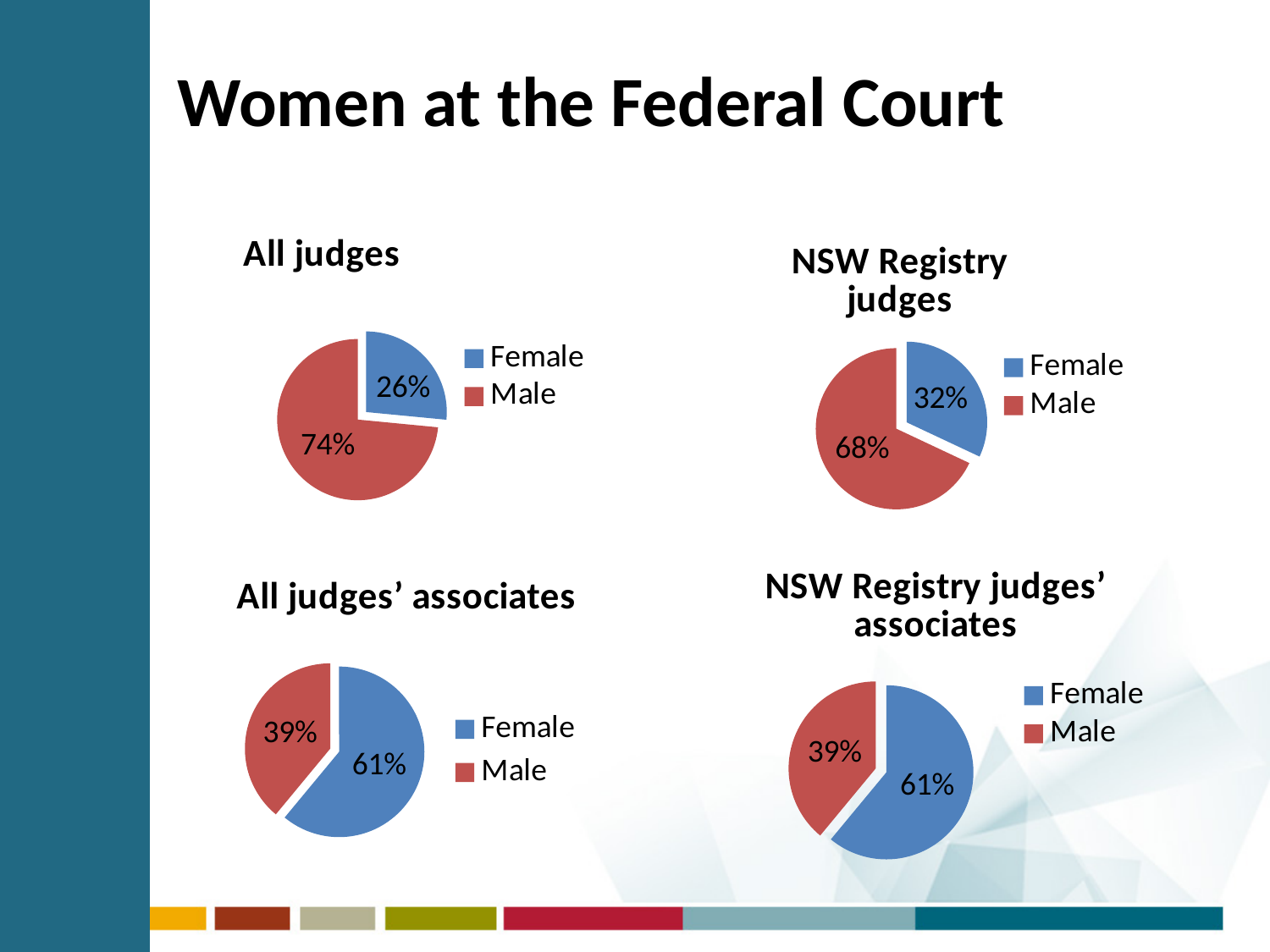
In the 'NSW Registry judges' associates' chart, which is larger, Female or Male? Female In the 'All judges' chart, which category has the largest share? Male In the 'All judges' associates' chart, which category has the smallest share? Male In the 'All judges' chart, what percentage is Male? 74% In the 'All judges' chart, what percentage is Female? 26% In the 'All judges' associates' chart, what percentage is Female? 61% In the 'NSW Registry judges' chart, what is the difference between the Male and Female percentages? 36% In the 'NSW Registry judges' chart, what percentage is Male? 68% How many entries does the legend of the 'NSW Registry judges' chart list? 2 In the 'NSW Registry judges' chart, what percentage is Female? 32% In the 'NSW Registry judges' associates' chart, what percentage is Male? 39% What type of chart is the 'All judges' chart? Pie chart